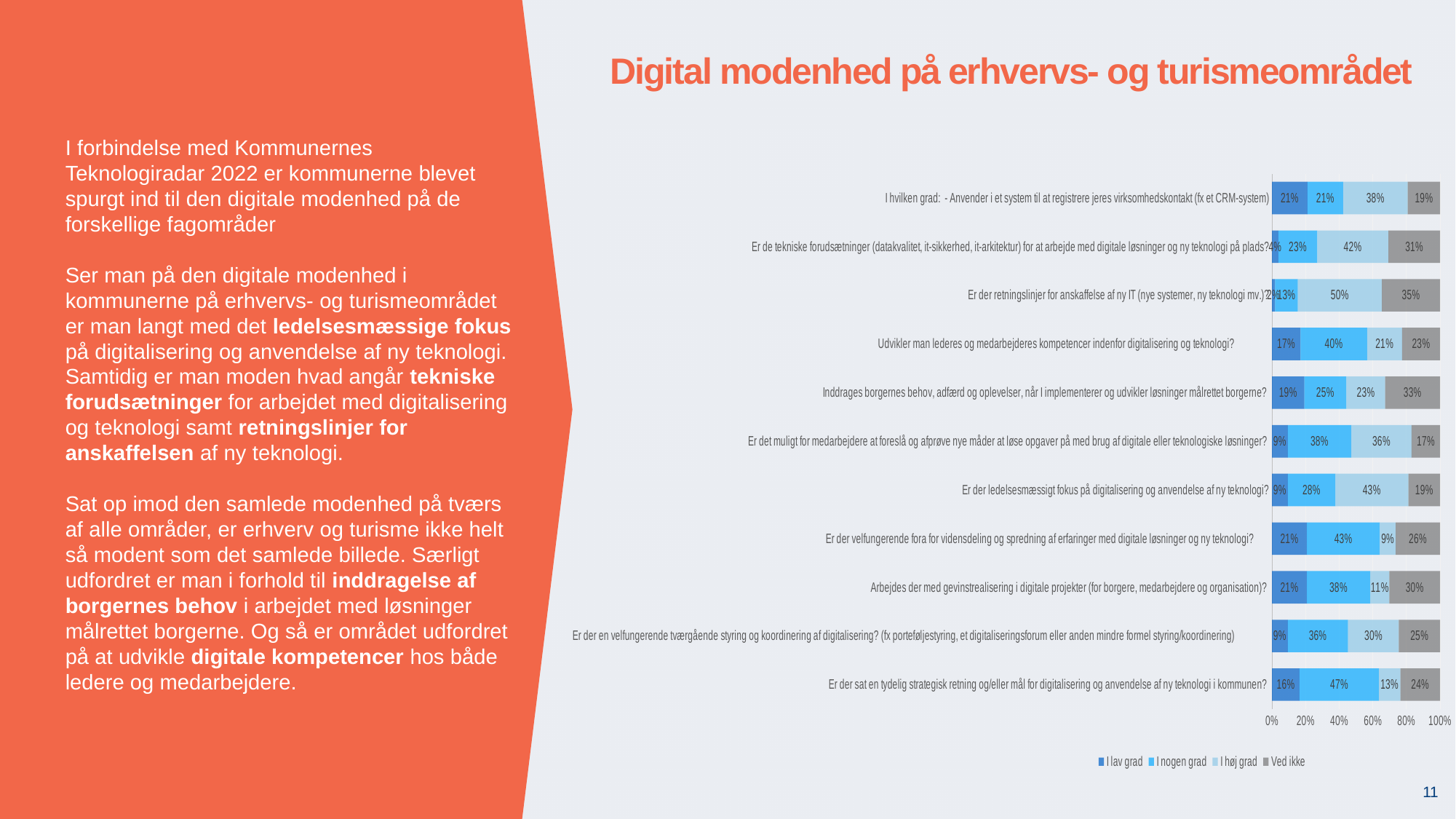
What is the 'I nogen grad' value for 'Er der sat en tydelig strategisk retning og/eller mål for digitalisering og anvendelse af ny teknologi i kommunen?' 47% What kind of chart is shown on the slide? Stacked bar chart What is the 'I høj grad' value for 'Er der retningslinjer for anskaffelse af ny IT (nye systemer, ny teknologi mv.)?' 50% What is the title of the chart slide? Digital modenhed på erhvervs- og turismeområdet How many questions (categories) are plotted in the chart? 11 How many series does the legend list? 4 Which question has the lowest 'I høj grad' value? Er der velfungerende fora for vidensdeling og spredning af erfaringer med digitale løsninger og ny teknologi? What is the total of the stacked bar for 'Er der sat en tydelig strategisk retning og/eller mål for digitalisering og anvendelse af ny teknologi i kommunen?' 100% What is the difference between the 'I høj grad' value for 'Er der ledelsesmæssigt fokus på digitalisering og anvendelse af ny teknologi?' (43%) and for 'Udvikler man lederes og medarbejderes kompetencer indenfor digitalisering og teknologi?' (21%)? 22% Which is larger: the 'Ved ikke' value for 'Arbejdes der med gevinstrealisering i digitale projekter' or for 'Er det muligt for medarbejdere at foreslå og afprøve nye måder at løse opgaver på'? Arbejdes der med gevinstrealisering i digitale projekter Which question has the highest 'I høj grad' value? Er der retningslinjer for anskaffelse af ny IT (nye systemer, ny teknologi mv.)? What is the 'Ved ikke' value for 'Inddrages borgernes behov, adfærd og oplevelser, når I implementerer og udvikler løsninger målrettet borgerne?' 33%